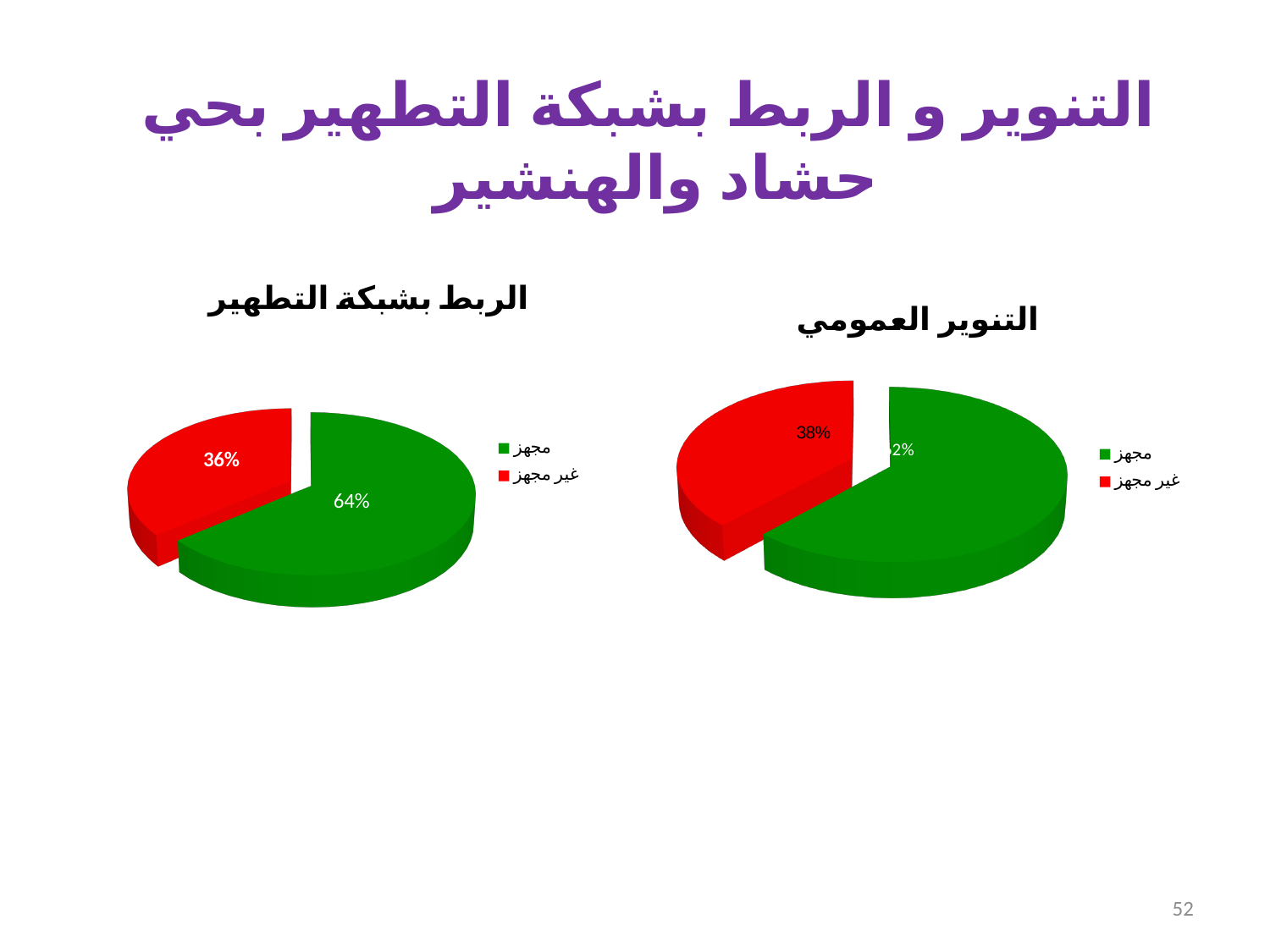
In the chart titled الربط بشبكة التطهير, what colour is the slice for غير مجهز? Red In the chart titled التنوير العمومي, what percentage is shown for غير مجهز? 38% In the chart titled الربط بشبكة التطهير, which category has the largest share? مجهز In the chart titled التنوير العمومي, which slice is larger, مجهز or غير مجهز? مجهز How many entries does the legend of the chart titled التنوير العمومي list? 2 In the chart titled الربط بشبكة التطهير, which category has the smallest share? غير مجهز In the chart titled الربط بشبكة التطهير, what percentage is shown for مجهز? 64% How many slices does the chart titled الربط بشبكة التطهير have? 2 In the chart titled الربط بشبكة التطهير, what percentage is shown for غير مجهز? 36% In the chart titled الربط بشبكة التطهير, what is the difference in percentage points between مجهز and غير مجهز? 28 What is the title of the chart on the right side of the slide? التنوير العمومي What type of chart is the one titled التنوير العمومي? Pie chart